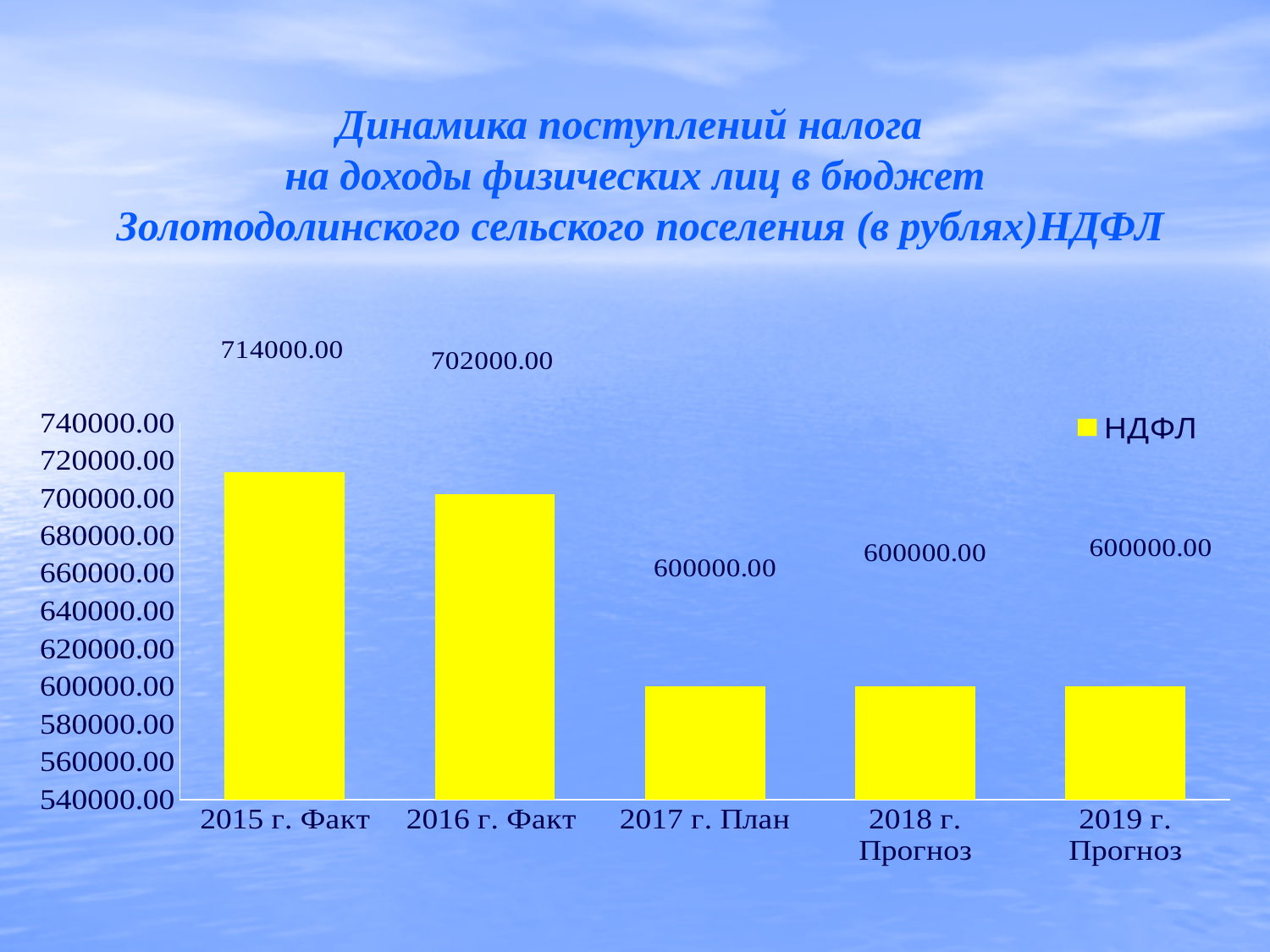
Is the value for 2016 г. Факт greater or less than 680000.00? greater How many categories are shown on the x axis? 5 What is the value for 2015 г. Факт? 714000.00 What is the difference between the values for 2015 г. Факт and 2016 г. Факт? 12000.00 What is the name of the series shown in the legend? НДФЛ What kind of chart is shown on the slide? bar chart Which category has the highest value? 2015 г. Факт What is the value for 2017 г. План? 600000.00 How many series does the legend list? 1 Which is larger, the value for 2015 г. Факт or the value for 2018 г. Прогноз? 2015 г. Факт What is the value for 2016 г. Факт? 702000.00 What is the difference between the values for 2016 г. Факт and 2017 г. План? 102000.00